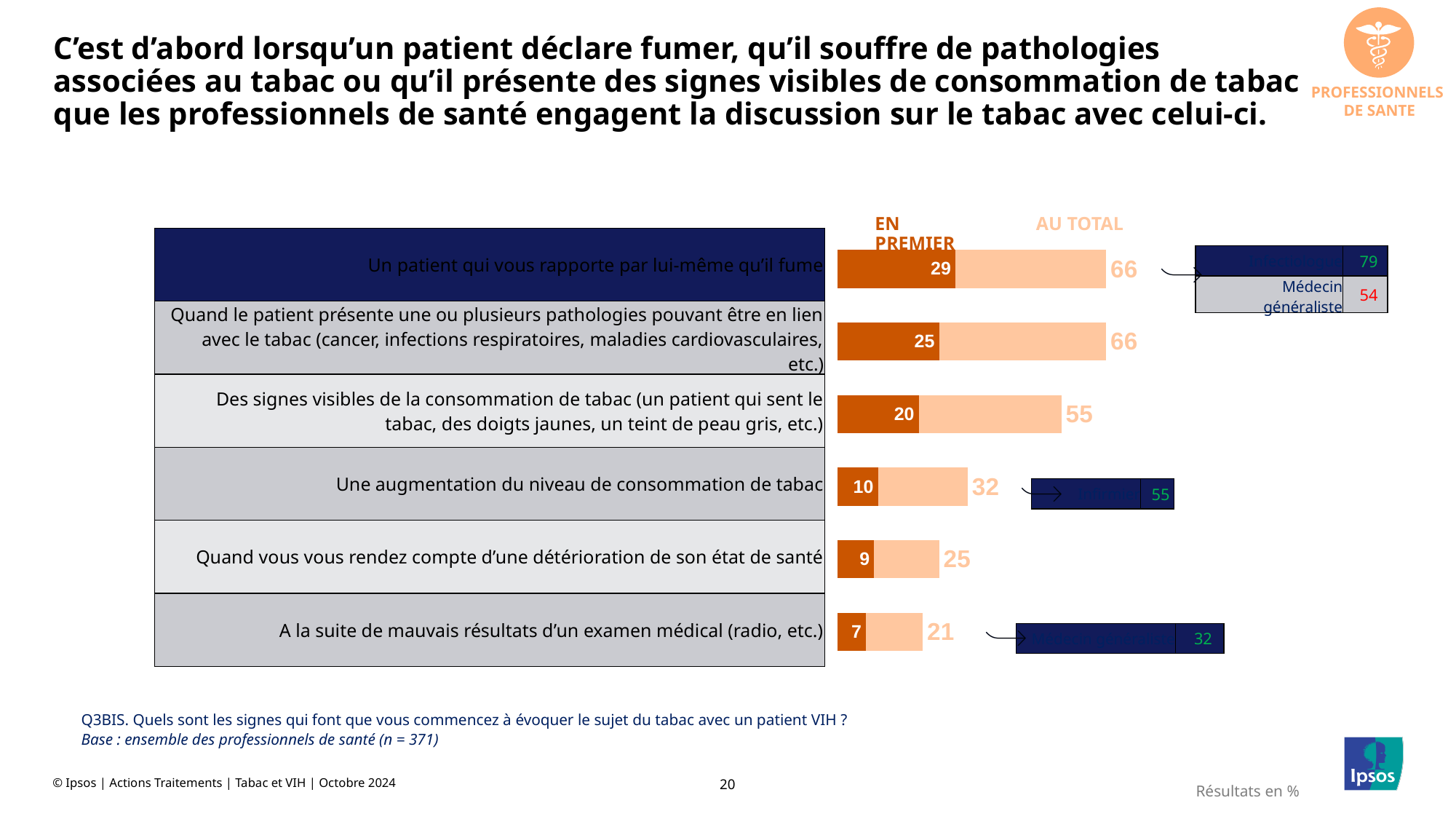
What kind of chart is shown on the slide? Bar chart What is the 'EN PREMIER' value for 'A la suite de mauvais résultats d'un examen médical (radio, etc.)'? 7 What is the 'AU TOTAL' value for 'Des signes visibles de la consommation de tabac (un patient qui sent le tabac, des doigts jaunes, un teint de peau gris, etc.)'? 55 What is the 'AU TOTAL' value for 'Une augmentation du niveau de consommation de tabac'? 32 What are the names of the two series shown in the chart? EN PREMIER and AU TOTAL Which category has the highest 'EN PREMIER' value? Un patient qui vous rapporte par lui-même qu'il fume How many categories are shown in the chart? 6 What is the difference between the 'AU TOTAL' and 'EN PREMIER' values for 'Quand vous vous rendez compte d'une détérioration de son état de santé'? 16 Which is larger: the 'EN PREMIER' value for 'Quand le patient présente une ou plusieurs pathologies pouvant être en lien avec le tabac' or for 'Des signes visibles de la consommation de tabac'? Quand le patient présente une ou plusieurs pathologies pouvant être en lien avec le tabac Which category has the lowest 'AU TOTAL' value? A la suite de mauvais résultats d'un examen médical (radio, etc.) How many series does the chart show? 2 What is the 'EN PREMIER' value for 'Un patient qui vous rapporte par lui-même qu'il fume'? 29